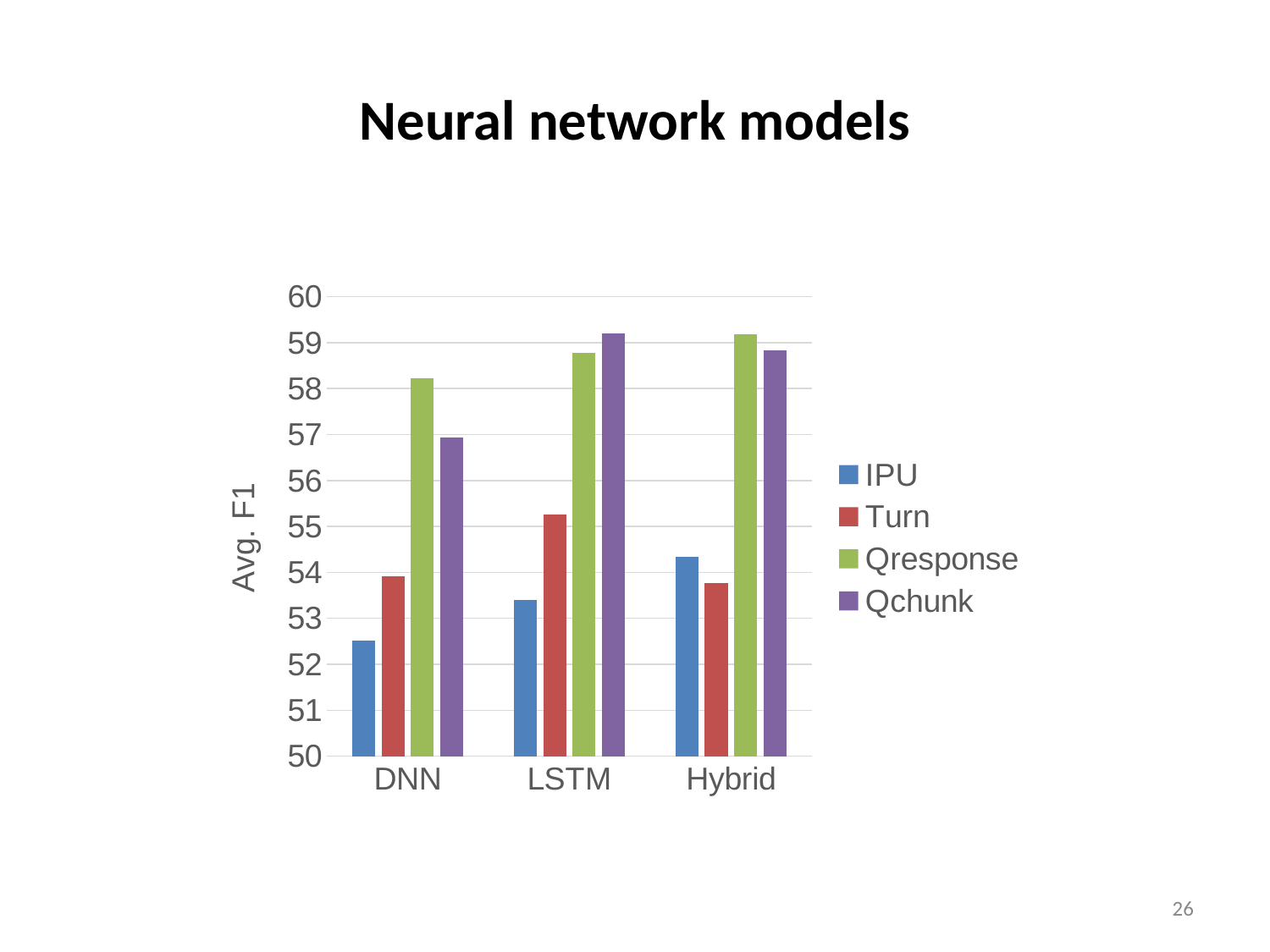
Which model has the highest IPU value? Hybrid For DNN, which is larger, the Qresponse value or the Qchunk value? Qresponse Is the Turn value for Hybrid greater or less than 54? less Is the IPU value for DNN greater or less than 53? less What kind of chart is shown on the slide? bar chart Which series has the lowest value for DNN? IPU Do the IPU values rise or fall moving from DNN to LSTM to Hybrid? rise Is the Turn value for LSTM greater or less than 55? greater What is the label of the vertical axis? Avg. F1 How many series does the legend list? 4 How many neural network models (categories) are shown on the x axis? 3